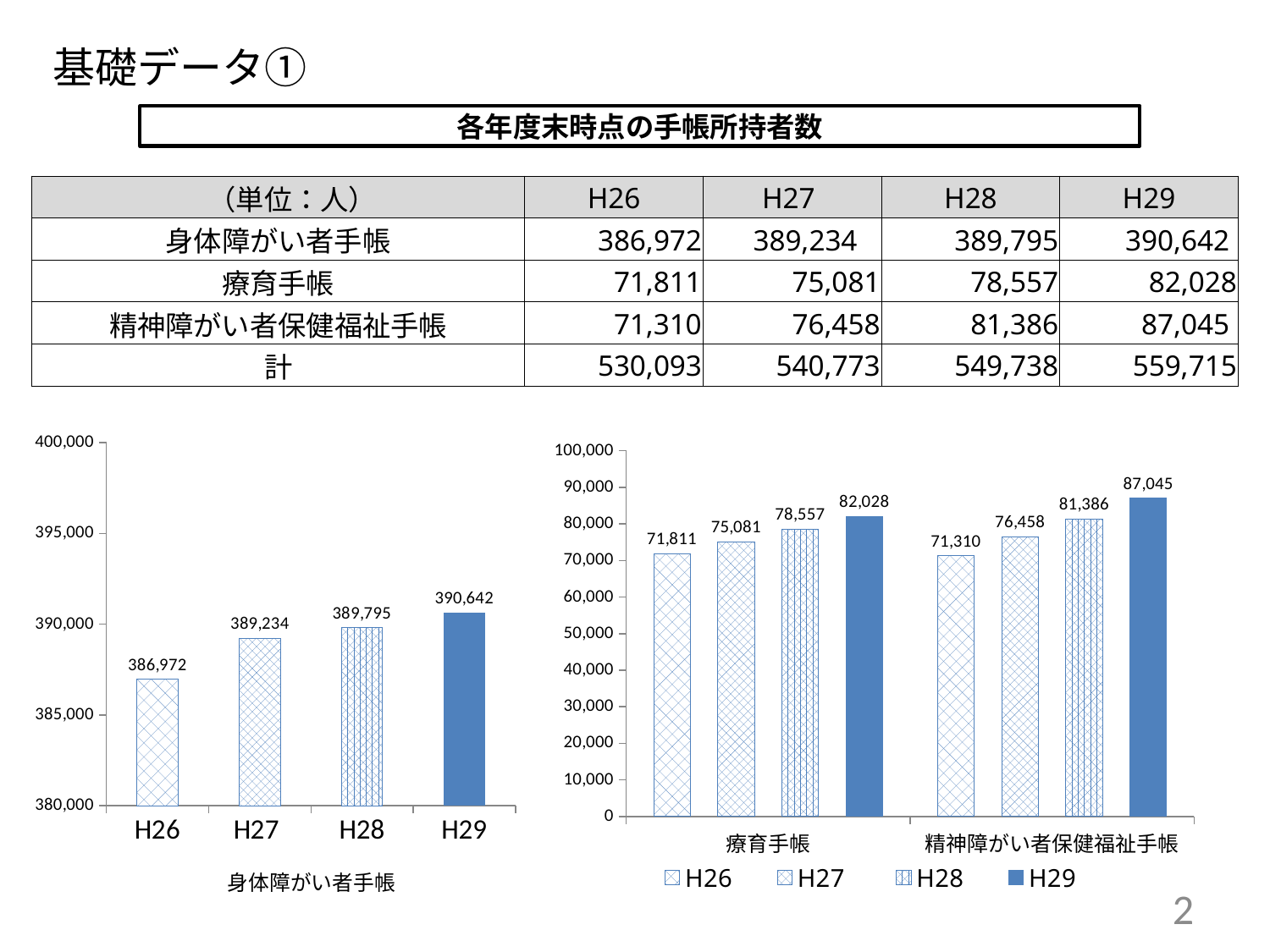
In the left chart (身体障がい者手帳), which year has the lowest value? H26 In the right chart, what is the H28 value for 精神障がい者保健福祉手帳? 81,386 In the left chart (身体障がい者手帳), what is the difference between the H29 and H26 values? 3,670 In the left chart (身体障がい者手帳), do the values rise or fall from H26 to H29? rise In the left chart (身体障がい者手帳), which year has the highest value? H29 In the right chart, what is the H26 value for 療育手帳? 71,811 In the left chart (身体障がい者手帳), how many bars are plotted? 4 What type of chart is the right chart? bar chart In the right chart, what is the difference between the H29 and H26 values for 精神障がい者保健福祉手帳? 15,735 In the right chart, which is larger: the H29 value for 療育手帳 or the H29 value for 精神障がい者保健福祉手帳? 精神障がい者保健福祉手帳 In the right chart, how many series does the legend list? 4 In the left chart (身体障がい者手帳), what is the value for H27? 389,234